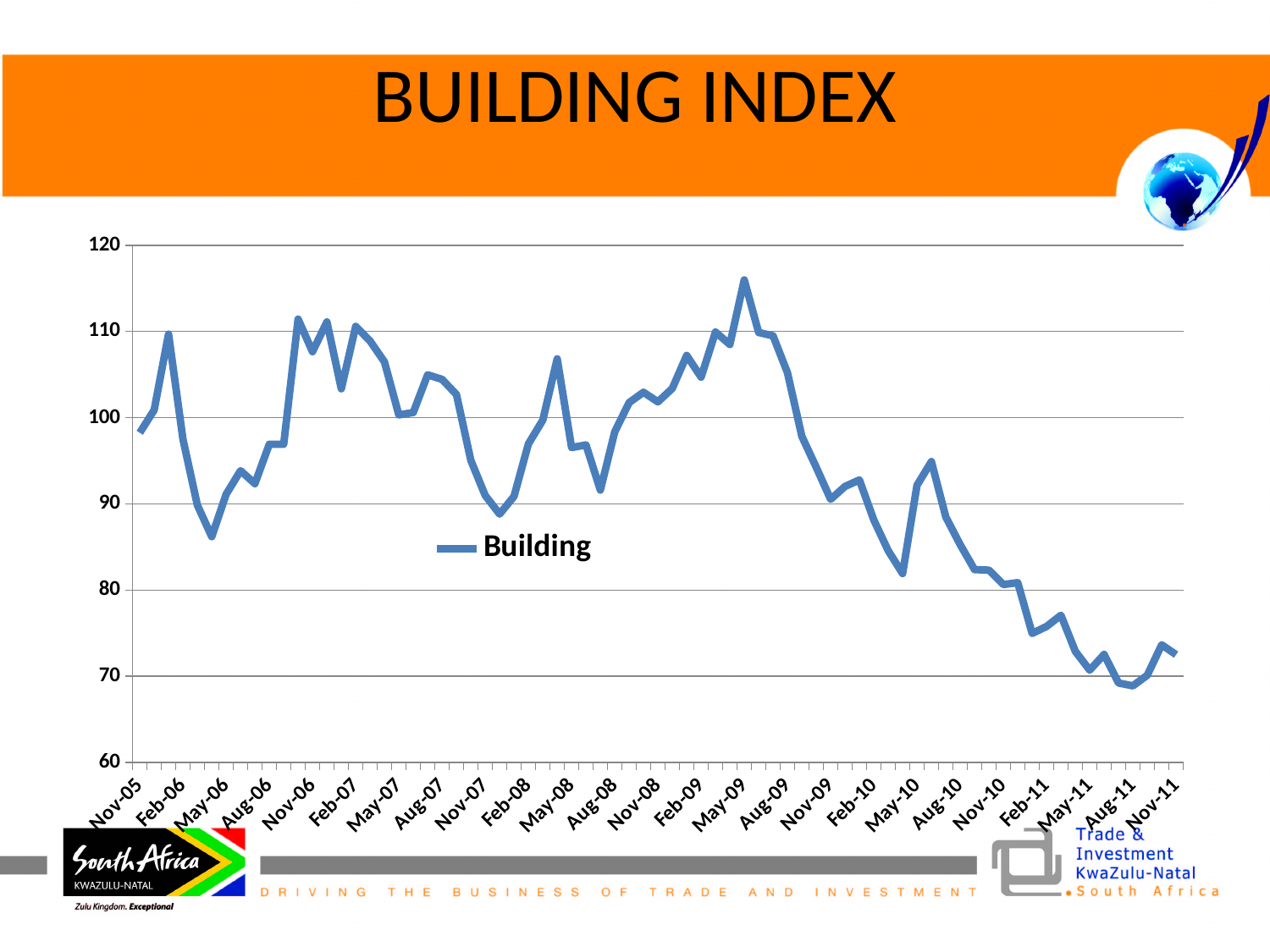
What is the name of the series shown in the legend? Building What is the title of the slide's chart? BUILDING INDEX How many series does the legend list? 1 Overall, does the Building index rise or fall from Nov-05 to Nov-11? fall Around which x-axis label does the Building index reach its lowest value? Aug-11 What kind of chart is shown on the slide? line chart Is the Building index value at May-10 greater or less than 90? greater Is the Building index value at Feb-11 greater or less than 80? less Around which x-axis label does the Building index reach its highest value? May-09 Which is larger, the Building index value at May-09 or at Nov-11? May-09 Is the Building index value at May-09 greater or less than 110? greater